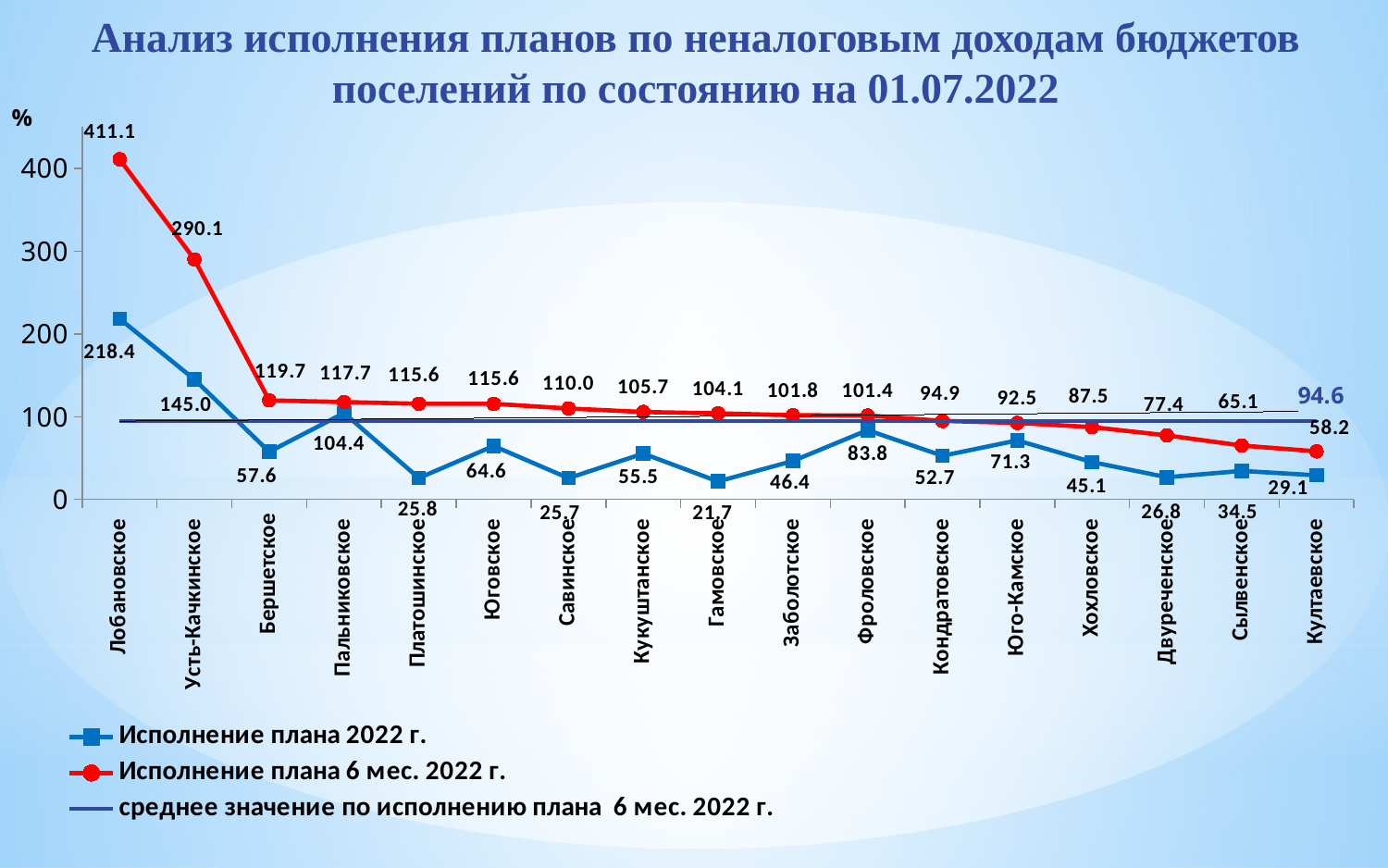
What is the value of 'Исполнение плана 6 мес. 2022 г.' for Култаевское? 58.2 What kind of chart is shown on the slide? line chart How many settlements are shown on the x axis? 17 What is the value of 'Исполнение плана 6 мес. 2022 г.' for Лобановское? 411.1 How many series does the legend list? 3 Is the value of 'Исполнение плана 6 мес. 2022 г.' for Усть-Качкинское greater or less than 200? greater What is the value of 'Исполнение плана 2022 г.' for Фроловское? 83.8 Which settlement has the highest value for 'Исполнение плана 6 мес. 2022 г.'? Лобановское Which settlement has the lowest value for 'Исполнение плана 6 мес. 2022 г.'? Култаевское What is the difference between 'Исполнение плана 6 мес. 2022 г.' and 'Исполнение плана 2022 г.' for Лобановское? 192.7 Which has the larger value for 'Исполнение плана 2022 г.': Пальниковское or Бершетское? Пальниковское Which settlement has the lowest value for 'Исполнение плана 2022 г.'? Гамовское